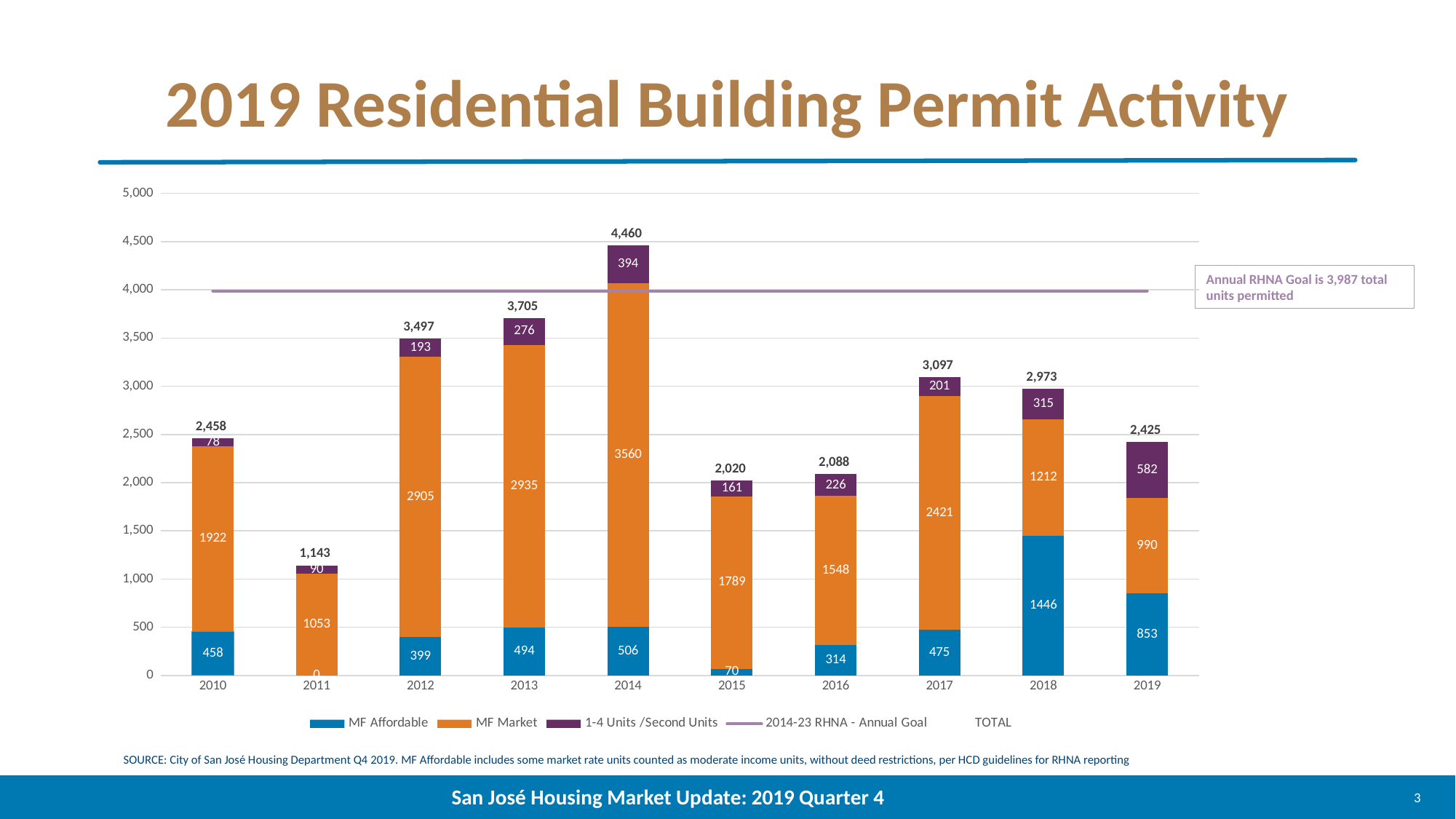
Which year has the lowest total units permitted? 2011 Which is larger, the MF Market value for 2017 or the MF Market value for 2016? 2017 What is the total number of units permitted in 2014? 4,460 What is the difference between the total units permitted in 2013 and in 2012? 208 What is the annual RHNA goal stated in the text box on the slide? 3,987 total units permitted How many entries does the legend list? 5 Which year has the highest total units permitted? 2014 What kind of chart is shown on the slide? Stacked bar chart with a line (combination bar and line chart) What is the MF Affordable value for 2018? 1446 Is the total for 2019 greater or less than 2,500? less What is the 1-4 Units / Second Units value for 2019? 582 How many years are shown on the x axis? 10